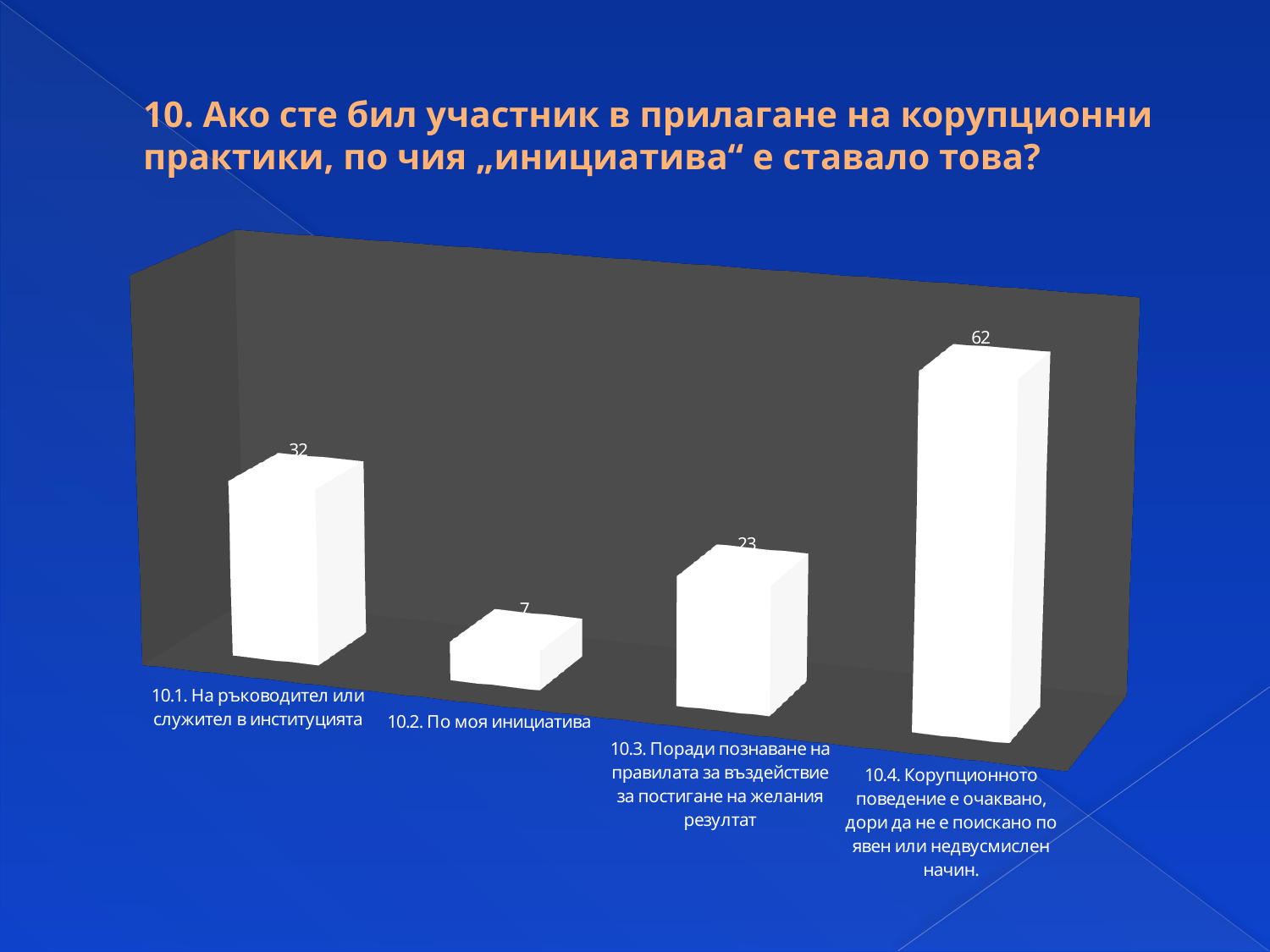
Which category has the highest value? 10.4. Корупционното поведение е очаквано, дори да не е поискано по явен или недвусмислен начин. What is the difference between the values for category 10.4 and category 10.1? 30 How many categories are shown in the chart? 4 What kind of chart is shown on the slide? Bar chart What is the total of all four values shown in the chart? 124 Which category has the lowest value? 10.2. По моя инициатива What is the value for category 10.4 "Корупционното поведение е очаквано, дори да не е поискано по явен или недвусмислен начин"? 62 Which is larger, the value for category 10.1 or the value for category 10.3? 10.1. На ръководител или служител в институцията What is the value for category 10.3 "Поради познаване на правилата за въздействие за постигане на желания резултат"? 23 What is the value for category 10.1 "На ръководител или служител в институцията"? 32 What is the difference between the values for category 10.1 and category 10.3? 9 What is the value for category 10.2 "По моя инициатива"? 7